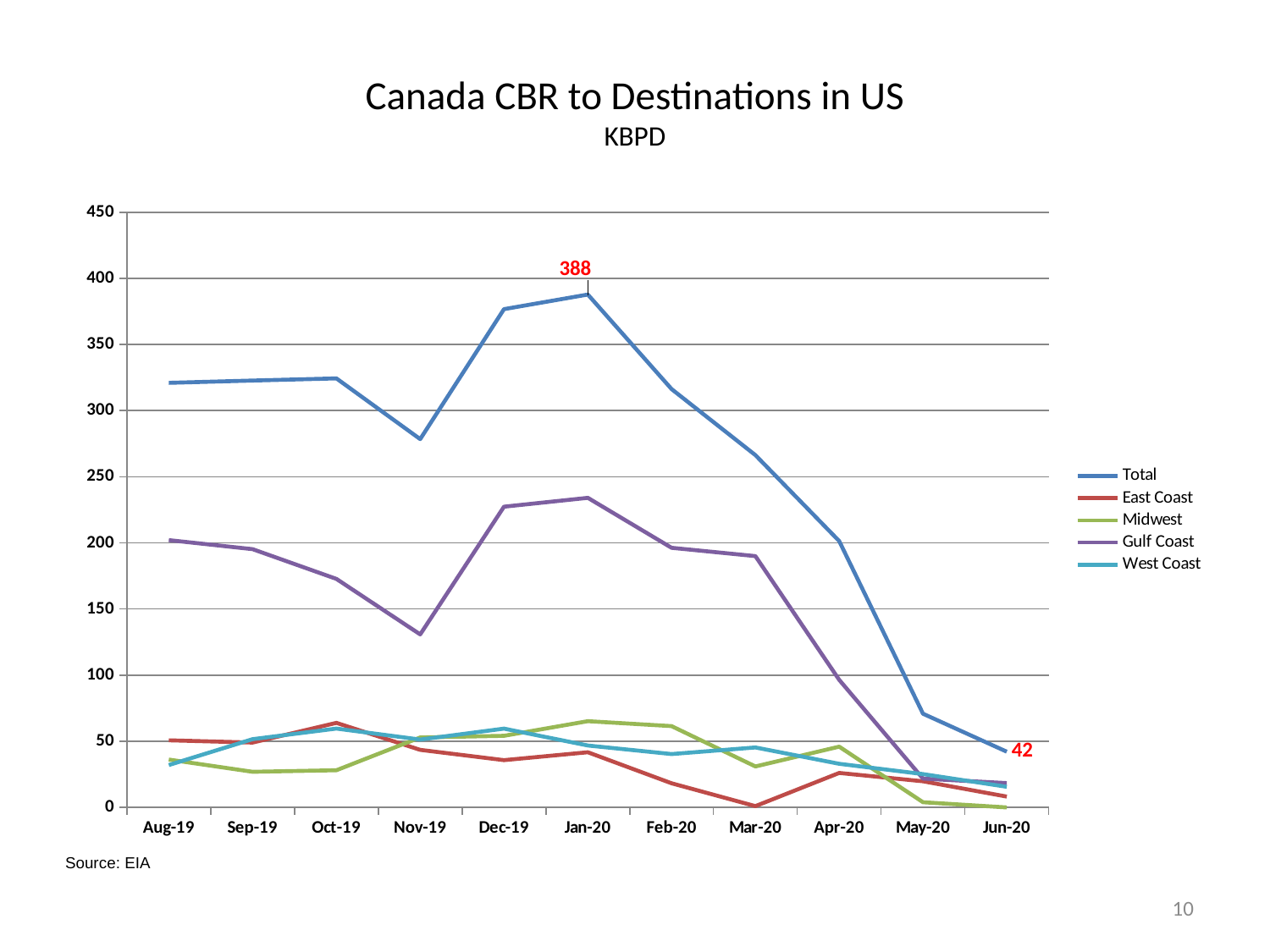
What kind of chart is shown on the slide? Line chart What is the Total value for Jun-20? 42 Does the Total series rise or fall from Jan-20 to Jun-20? Fall In which month does the Total series reach its lowest value? Jun-20 What is the Total value for Jan-20? 388 How many series does the legend list? 5 Is the Gulf Coast value for Jan-20 greater or less than 200? greater In Dec-19, which is larger: the Gulf Coast value or the Midwest value? Gulf Coast In which month does the Total series reach its highest value? Jan-20 Is the Total value for Nov-19 greater or less than 300? less How many months are shown on the x axis? 11 What is the difference between the Total value in Jan-20 and the Total value in Jun-20? 346